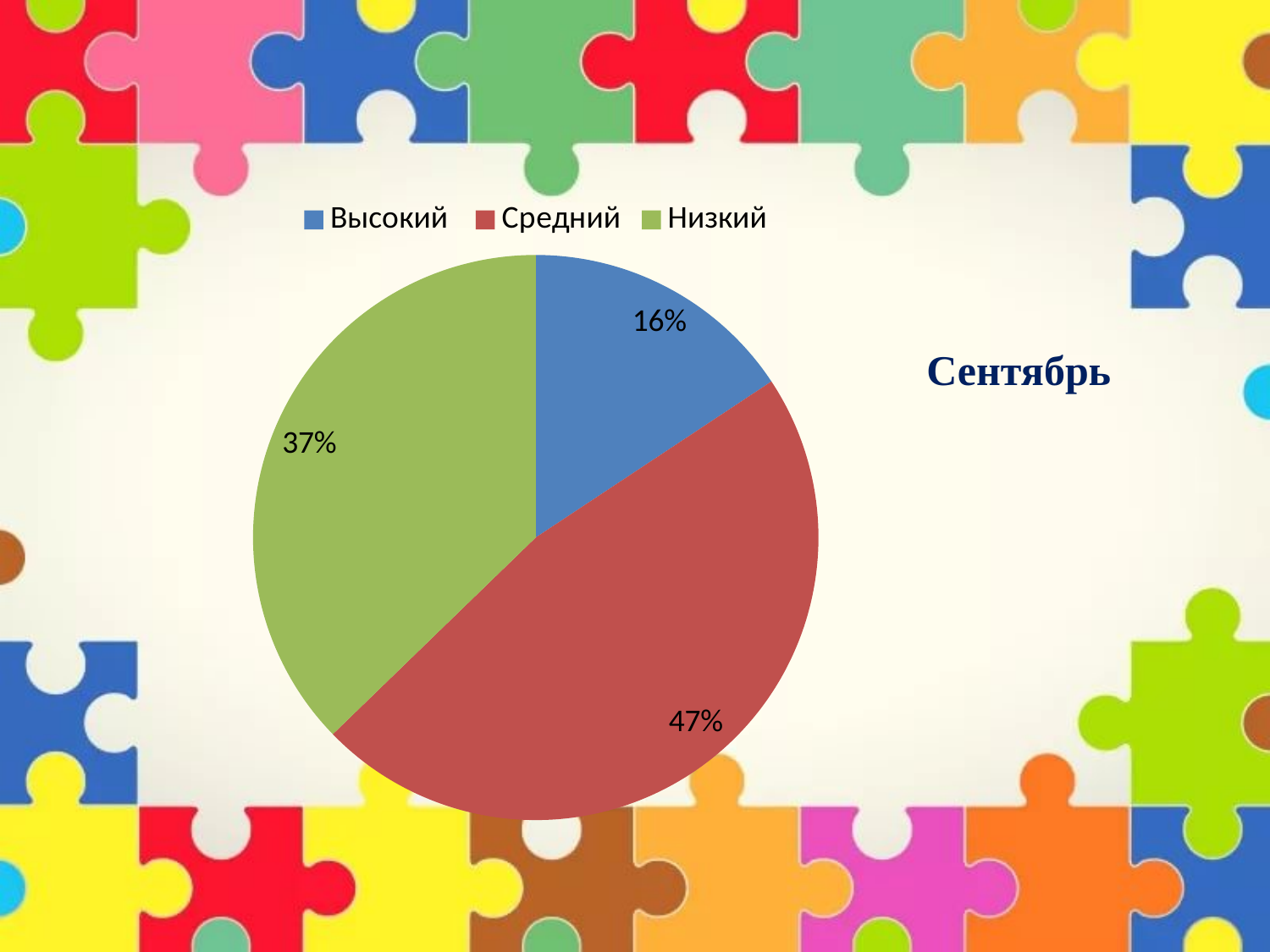
How many entries does the legend list? 3 Which category has the smallest slice of the pie? Высокий What share of the pie does Низкий have? 37% What is the difference in percentage points between Низкий and Высокий? 21 How many slices does the pie chart have? 3 What kind of chart is shown on the slide? pie chart What share of the pie does Высокий have? 16% What share of the pie does Средний have? 47% What is the difference in percentage points between Средний and Низкий? 10 Which category has the largest slice of the pie? Средний Which is larger, the slice for Низкий or the slice for Высокий? Низкий What colour is the slice for Средний? red